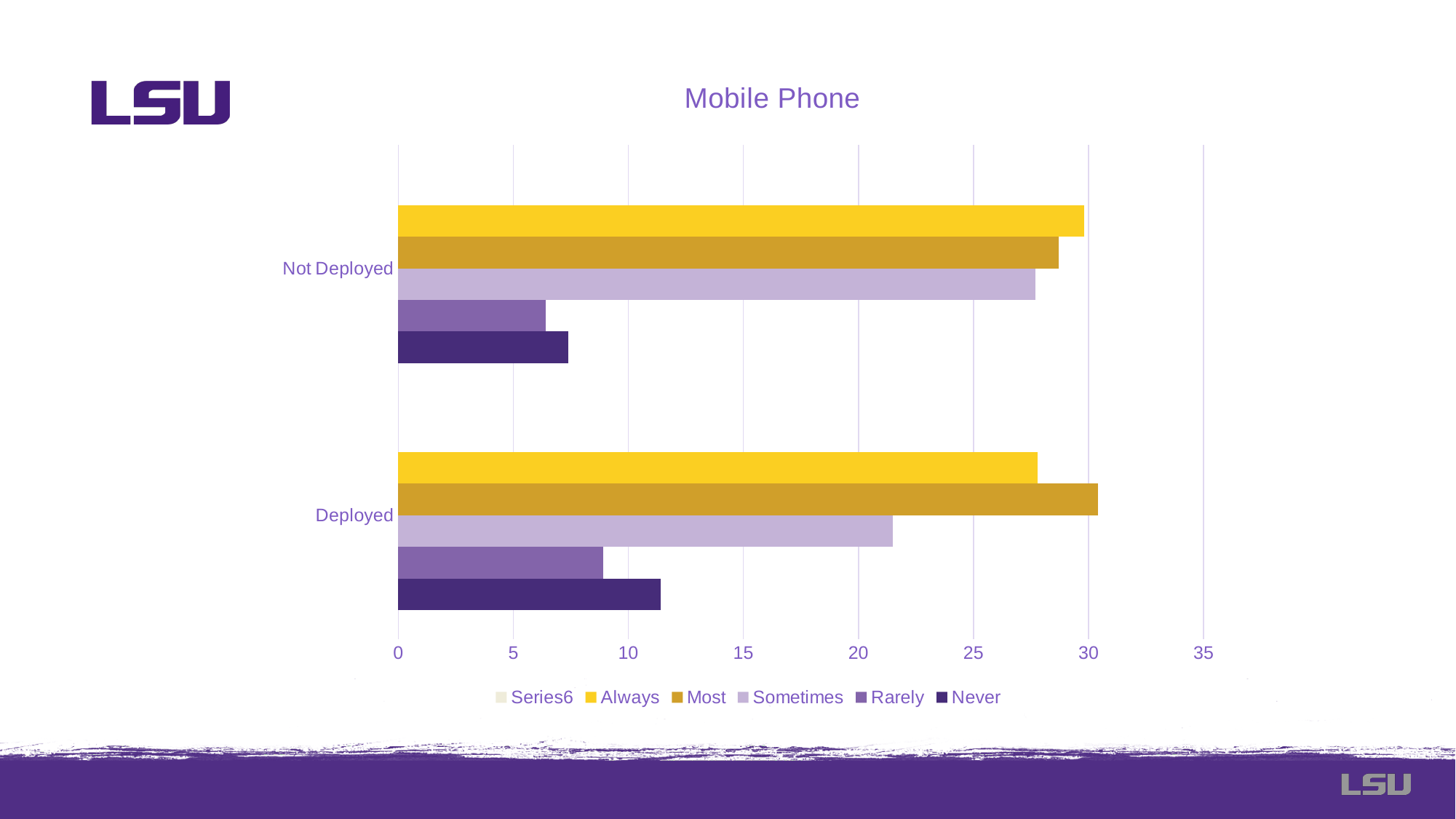
Which series has the lowest value for Deployed? Rarely Which series has the lowest value for Not Deployed? Rarely Is the value for Sometimes in the Deployed category greater or less than 20? greater How many categories are shown on the vertical axis? 2 What kind of chart is shown on the slide? bar chart Is the value for Always in the Not Deployed category greater or less than 25? greater How many series does the legend list? 6 Is the value for Rarely in the Not Deployed category greater or less than 10? less Which is larger, the Sometimes value for Deployed or the Sometimes value for Not Deployed? Not Deployed Which series has the highest value for Deployed? Most What is the title of the chart? Mobile Phone